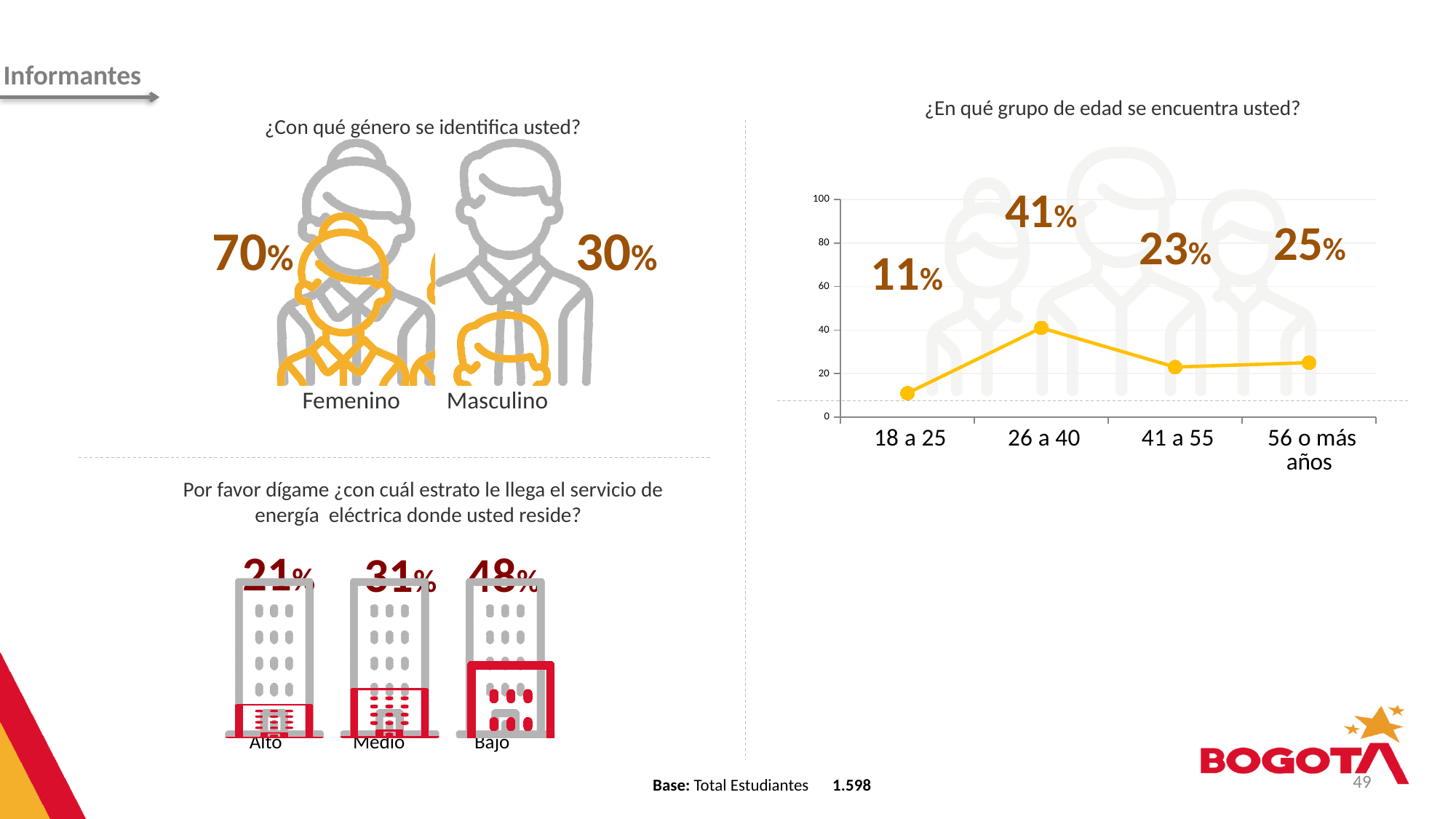
In the chart titled '¿En qué grupo de edad se encuentra usted?', does the value rise or fall from 18 a 25 to 26 a 40? rise In the chart titled '¿En qué grupo de edad se encuentra usted?', which age group has the lowest value? 18 a 25 In the chart titled '¿En qué grupo de edad se encuentra usted?', what is the value for the 26 a 40 age group? 41% In the chart titled '¿En qué grupo de edad se encuentra usted?', what is the difference between the values for 26 a 40 and 18 a 25? 30% How many age groups are plotted in the chart titled '¿En qué grupo de edad se encuentra usted?'? 4 In the chart titled '¿En qué grupo de edad se encuentra usted?', what is the highest value shown on the vertical axis? 100 In the chart titled '¿En qué grupo de edad se encuentra usted?', is the value for 18 a 25 greater or less than 20? less In the chart titled '¿En qué grupo de edad se encuentra usted?', which is larger: the value for 41 a 55 or for 56 o más años? 56 o más años What kind of chart is used for '¿En qué grupo de edad se encuentra usted?'? line chart In the chart titled '¿En qué grupo de edad se encuentra usted?', what is the value for the 18 a 25 age group? 11% In the chart titled '¿En qué grupo de edad se encuentra usted?', which age group has the highest value? 26 a 40 In the chart titled '¿En qué grupo de edad se encuentra usted?', what is the value for the 56 o más años age group? 25%